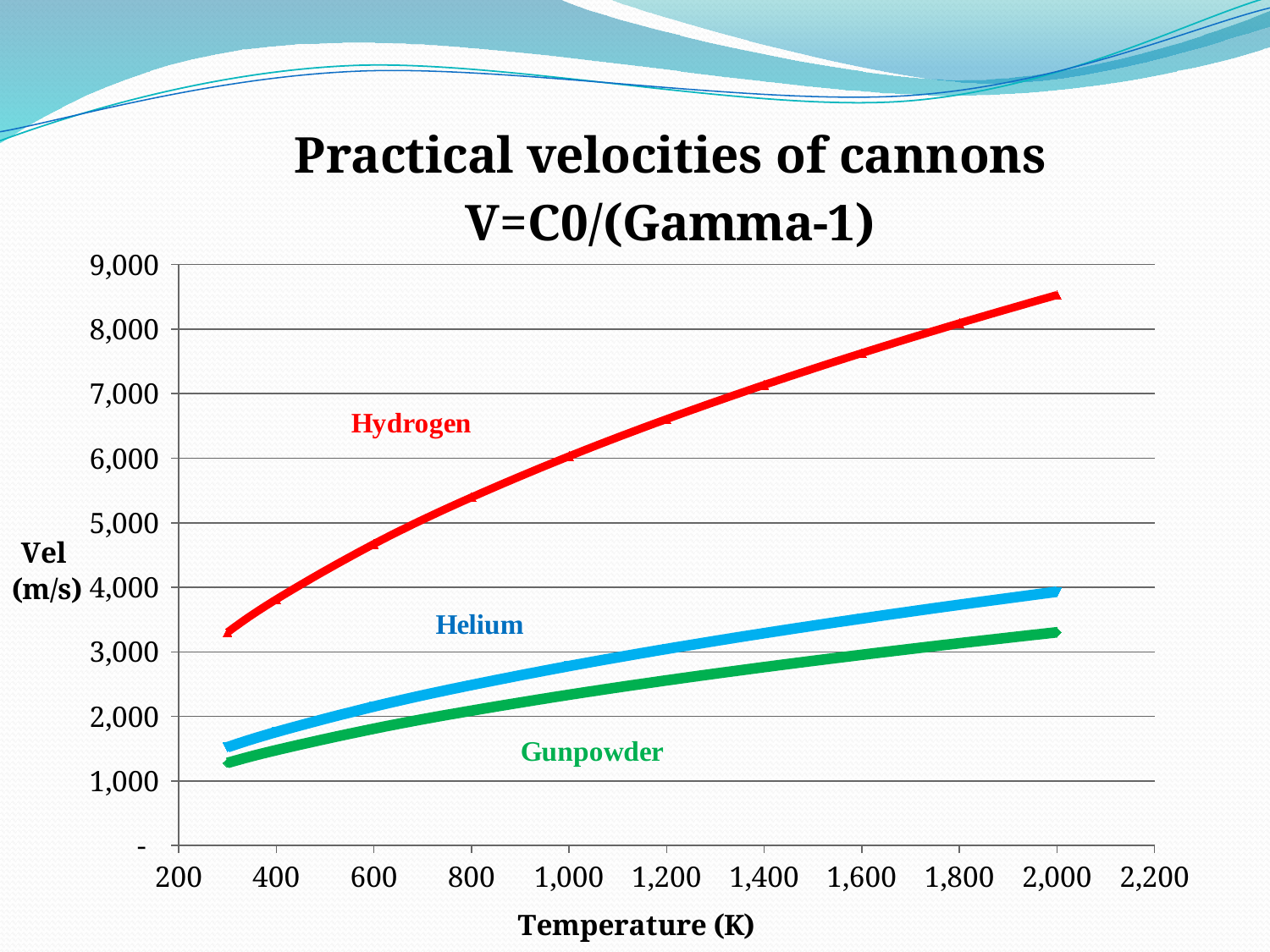
Do the velocities rise or fall as temperature increases along the x axis? rise At 1,000 K, which has the larger velocity, Helium or Gunpowder? Helium Is the Gunpowder velocity at 300 K greater or less than 2,000? less What is the title of the x axis? Temperature (K) Is the Hydrogen velocity at 2,000 K greater or less than 8,000? greater Which series has the lowest velocity at 2,000 K? Gunpowder What kind of chart is shown on the slide? line chart Is the Hydrogen velocity at 300 K greater or less than 3,000? greater How many data series are plotted on the chart? 3 Which series has the highest velocity at 2,000 K? Hydrogen What colour is the Hydrogen line? red